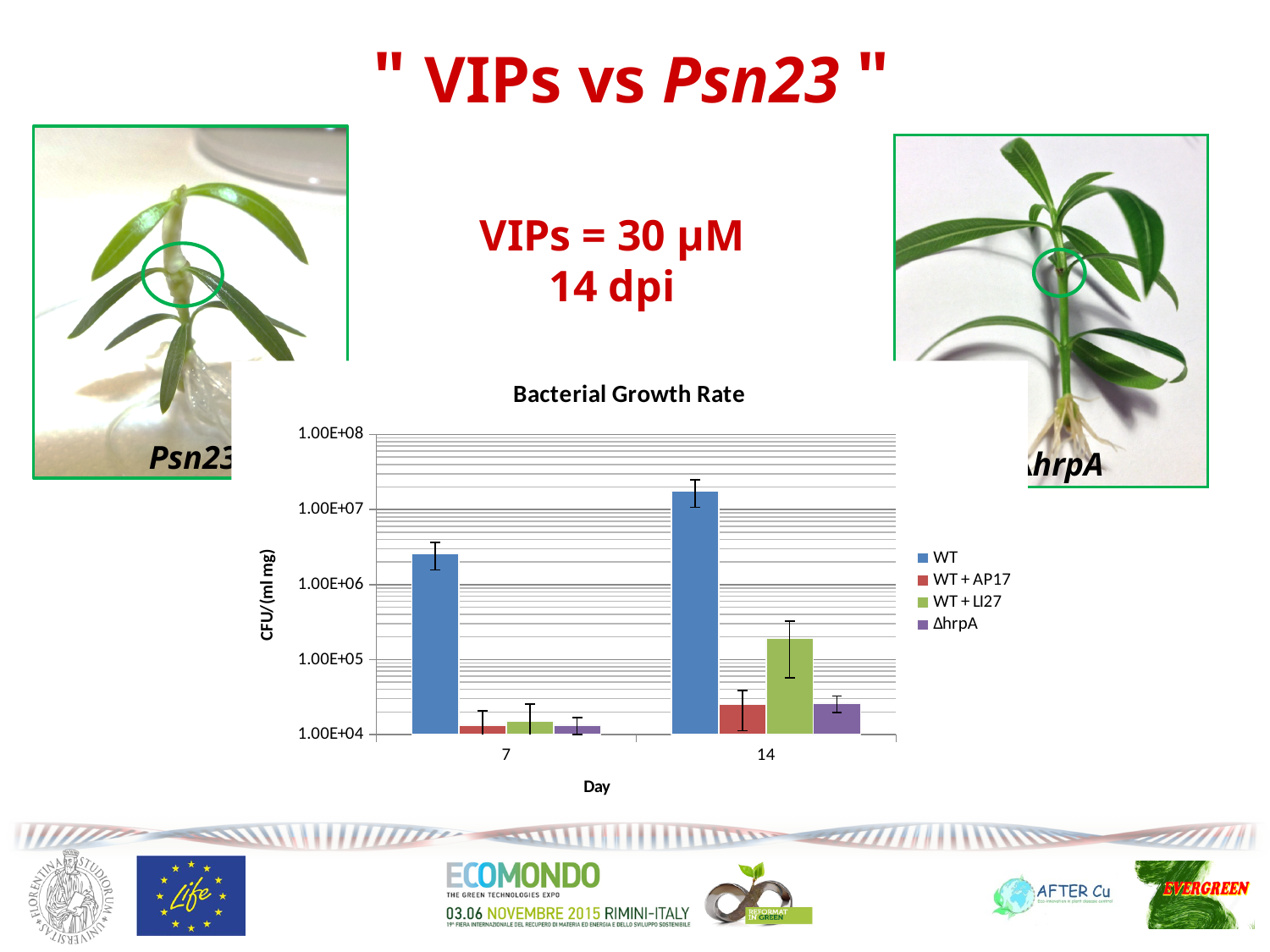
What kind of chart is the Bacterial Growth Rate chart? bar chart How many series does the legend of the Bacterial Growth Rate chart list? 4 What is the title of the chart on the slide? Bacterial Growth Rate What is the label of the y axis of the Bacterial Growth Rate chart? CFU/(ml mg) Which series has the highest value at Day 7 in the Bacterial Growth Rate chart? WT How many Day categories are shown on the x axis of the Bacterial Growth Rate chart? 2 At Day 14, which is larger: WT + LI27 or WT + AP17? WT + LI27 Is the WT + LI27 value at Day 14 greater or less than 1.00E+05? greater Is the WT value at Day 7 greater or less than 1.00E+07? less Does the WT value rise or fall from Day 7 to Day 14? rise Which series has the highest value at Day 14 in the Bacterial Growth Rate chart? WT Is the WT value at Day 14 greater or less than 1.00E+07? greater